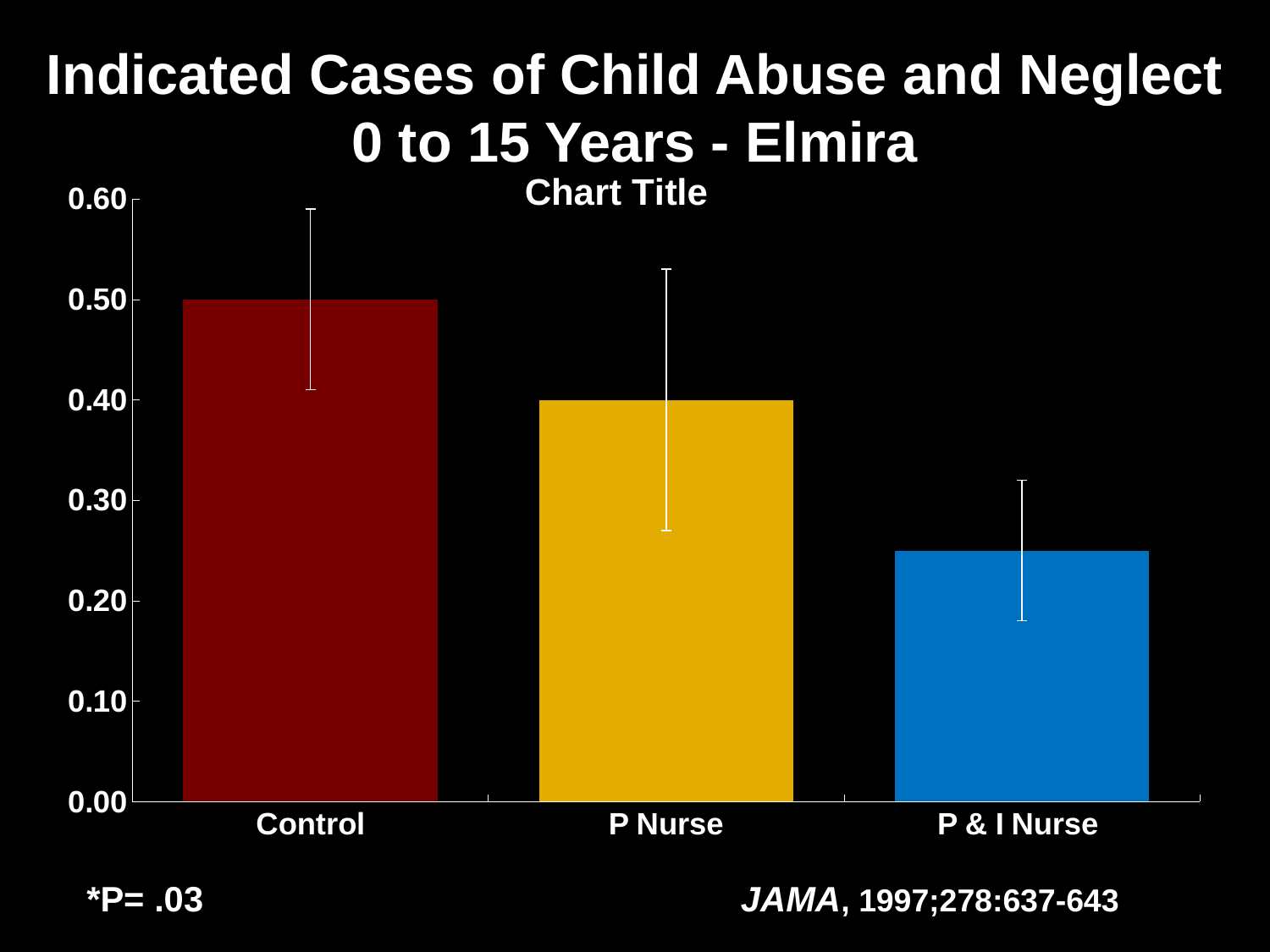
What is the difference between the values for Control and P Nurse? 0.10 Which is larger, the value for P Nurse or the value for P & I Nurse? P Nurse Is the value for P & I Nurse greater or less than 0.20? greater What is the highest tick value shown on the y axis? 0.60 Which category has the lowest value? P & I Nurse Which category has the highest value? Control How many categories are plotted on the x axis? 3 What is the value for P Nurse? 0.40 What kind of chart is shown on the slide? bar chart What is the value for Control? 0.50 Is the value for P & I Nurse greater or less than 0.30? less Do the bar values rise or fall from left to right along the x axis? fall